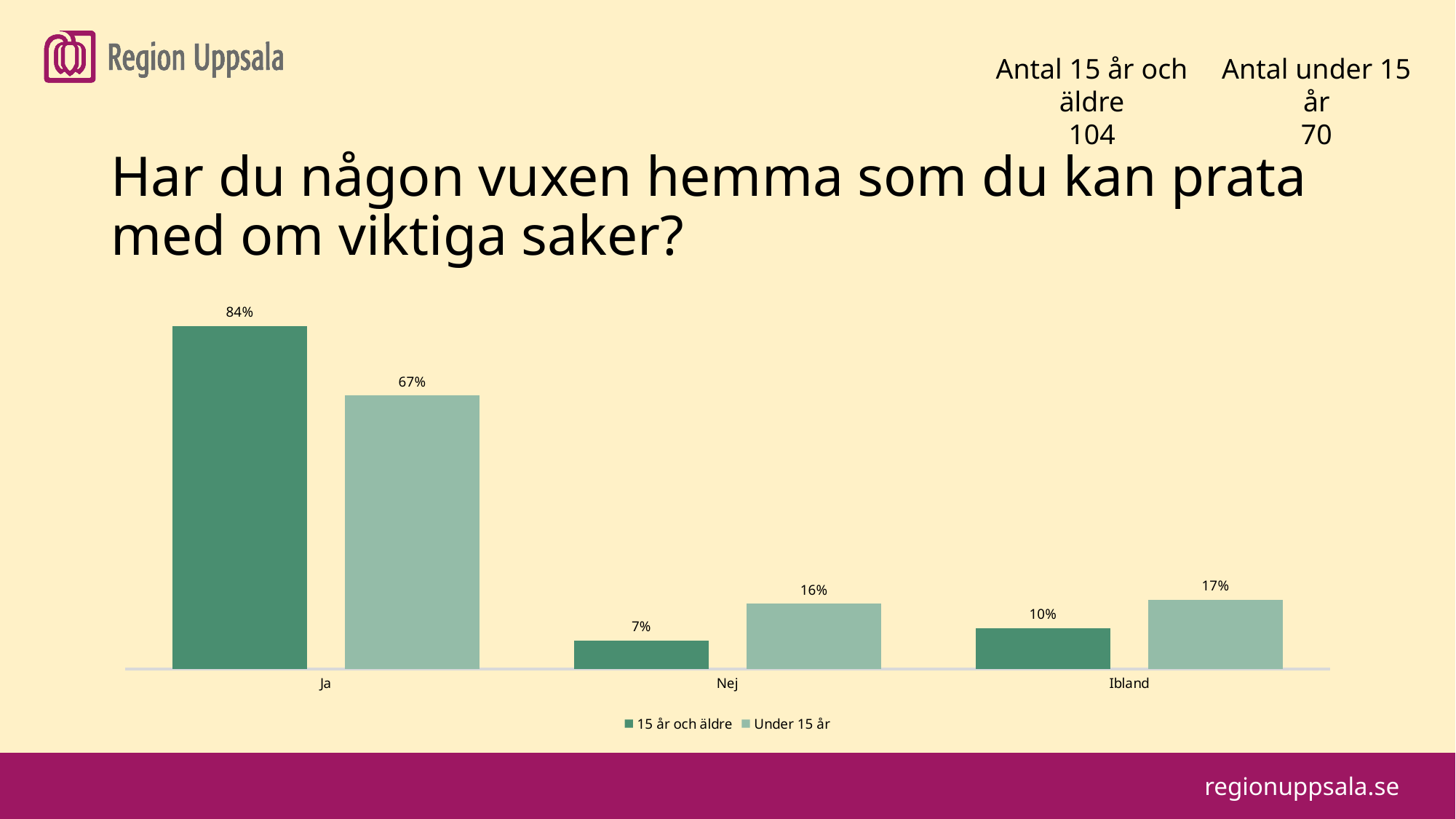
What is the difference between the "Under 15 år" values for "Ibland" and "Nej"? 1% What is the value for "Under 15 år" in the "Nej" category? 16% Which series has the larger value in the "Nej" category? Under 15 år What is the difference between the "15 år och äldre" and "Under 15 år" values in the "Ja" category? 17% Which category has the highest value for the "Under 15 år" series? Ja What is the value for "15 år och äldre" in the "Ibland" category? 10% How many series does the legend list? 2 What are the two series listed in the legend? 15 år och äldre; Under 15 år What is the value for "15 år och äldre" in the "Ja" category? 84% How many categories are shown on the x axis? 3 Which category has the lowest value for the "15 år och äldre" series? Nej What kind of chart is shown on the slide? Bar chart